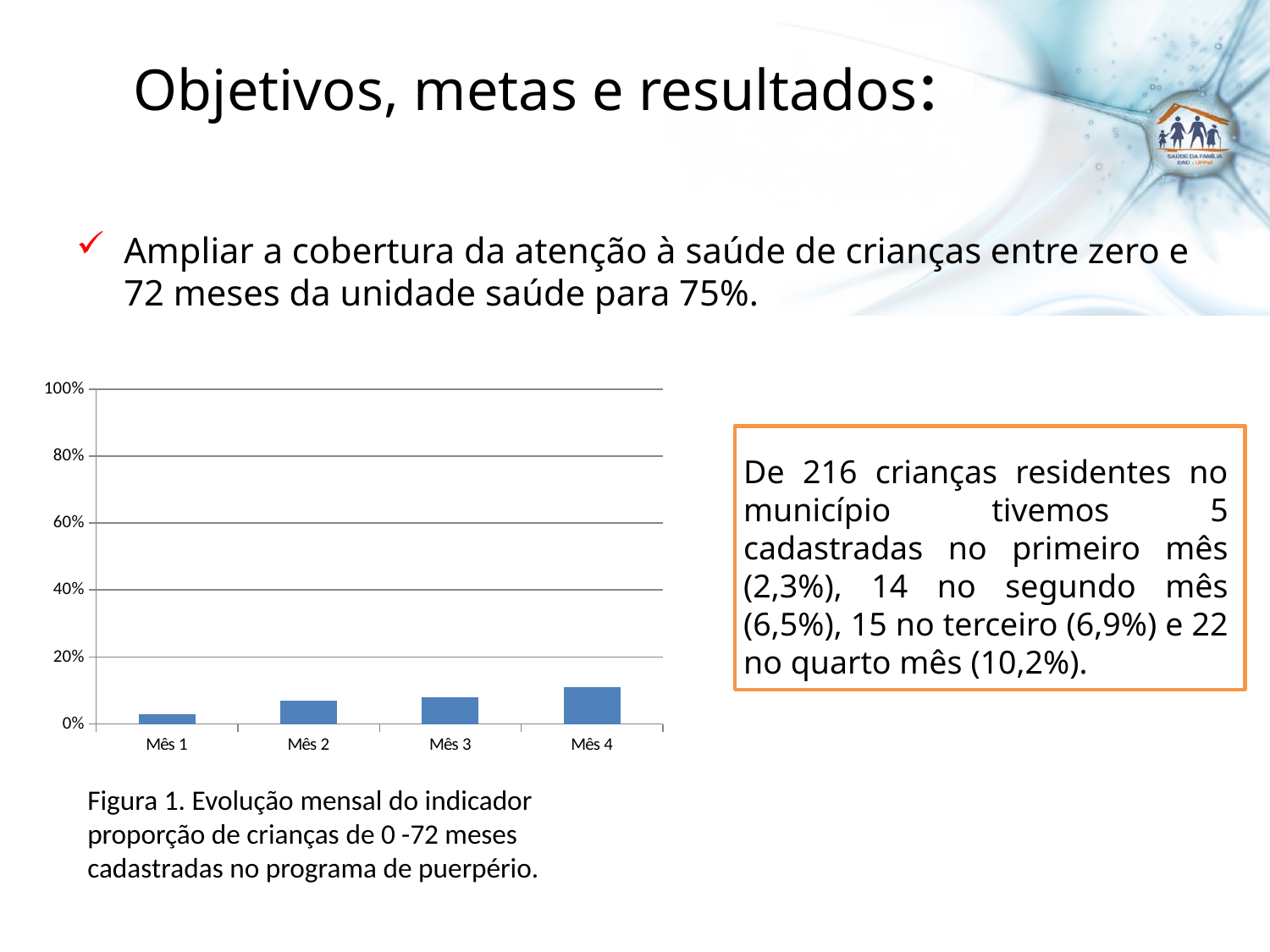
Which is larger, the value for Mês 4 or the value for Mês 2? Mês 4 Do the values rise or fall from Mês 1 to Mês 4? rise Is the value for Mês 4 greater or less than 20%? less Is the value for Mês 1 greater or less than 20%? less What kind of chart is shown on the slide? bar chart According to the slide, what proportion of children was registered in the fourth month (Mês 4)? 10,2% Which month has the lowest bar in the chart? Mês 1 What is the figure number given in the caption below the chart? Figura 1 Which month has the highest bar in the chart? Mês 4 How many months (categories) are plotted on the x axis of the chart? 4 What is the highest value shown on the y axis of the chart? 100% According to the slide, what proportion of children was registered in the first month (Mês 1)? 2,3%